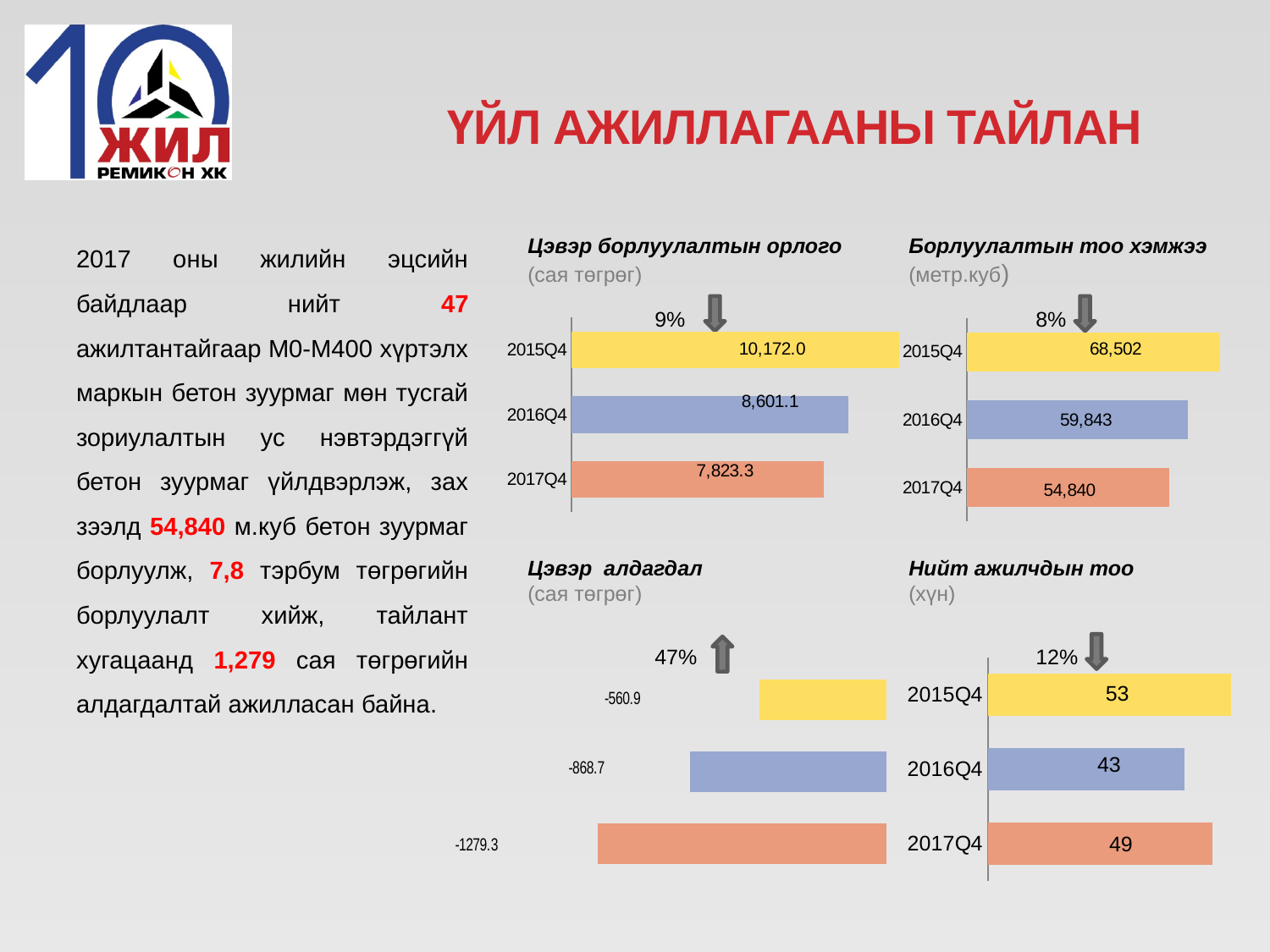
What kind of chart is the chart titled 'Цэвэр алдагдал'? bar chart In the chart titled 'Борлуулалтын тоо хэмжээ', what is the difference between the 2015Q4 and 2017Q4 values? 13,662 In the chart titled 'Цэвэр борлуулалтын орлого', do the values rise or fall from 2015Q4 to 2017Q4? fall In the chart titled 'Нийт ажилчдын тоо', what is the difference between the 2015Q4 and 2016Q4 values? 10 How many bars are shown in the chart titled 'Цэвэр алдагдал'? 3 In the chart titled 'Нийт ажилчдын тоо', what is the value for 2016Q4? 43 In the chart titled 'Цэвэр борлуулалтын орлого', what is the value for 2017Q4? 7,823.3 In the chart titled 'Борлуулалтын тоо хэмжээ', which period has the highest value? 2015Q4 In the chart titled 'Цэвэр борлуулалтын орлого', what is the value for 2015Q4? 10,172.0 In the chart titled 'Цэвэр борлуулалтын орлого', which period has the lowest value? 2017Q4 In the chart titled 'Борлуулалтын тоо хэмжээ', what is the value for 2016Q4? 59,843 In the chart titled 'Нийт ажилчдын тоо', which is larger, the value for 2016Q4 or 2017Q4? 2017Q4